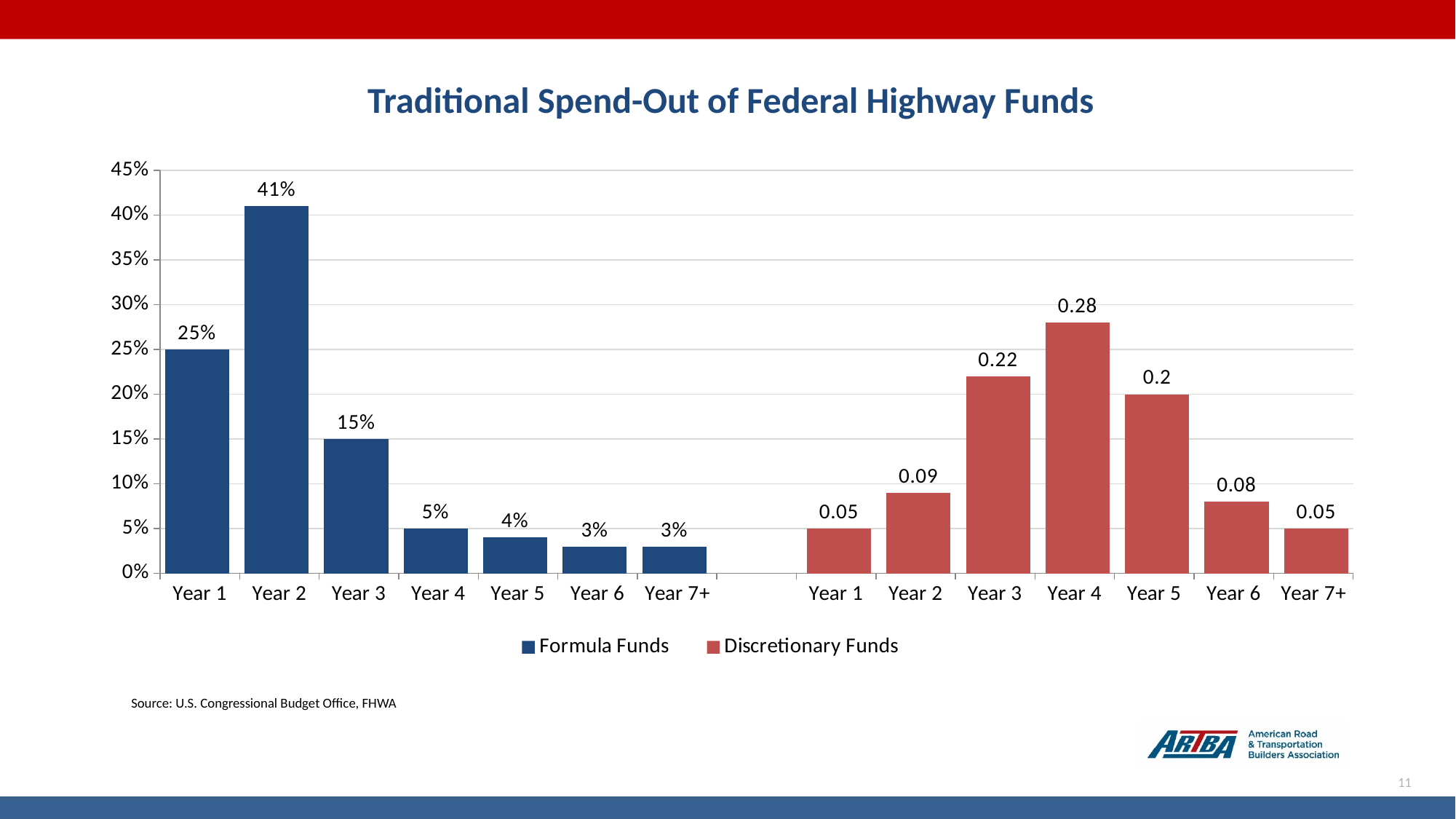
How many series does the legend list? 2 What is the Discretionary Funds value for Year 4? 0.28 Which year has the highest Formula Funds value? Year 2 What kind of chart is shown on the slide? Bar chart What is the difference between the Formula Funds values for Year 2 and Year 1? 16% What is the title of the chart? Traditional Spend-Out of Federal Highway Funds Which year has the highest Discretionary Funds value? Year 4 Which is larger, the Discretionary Funds value for Year 3 or for Year 5? Year 3 What is the Formula Funds value for Year 2? 41% Which year has the lowest Discretionary Funds value? Year 1 and Year 7+ What is the Formula Funds value for Year 3? 15% What is the Discretionary Funds value for Year 2? 0.09